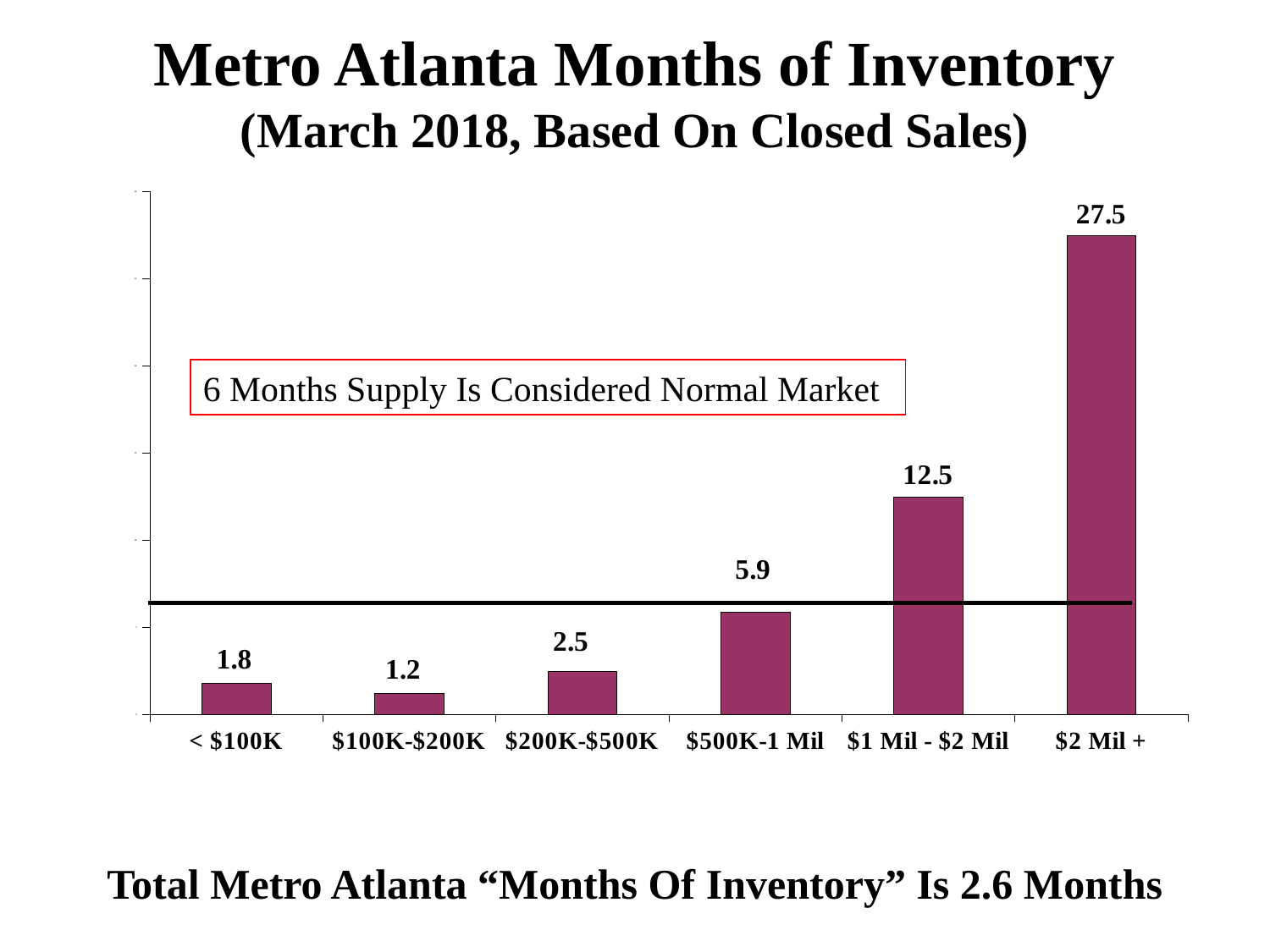
How many price range categories are shown on the chart? 6 Which price range has the lowest months of inventory? $100K-$200K What is the months of inventory value for the $1 Mil - $2 Mil price range? 12.5 Which price range has the highest months of inventory? $2 Mil + According to the text box on the chart, how many months of supply is considered a normal market? 6 months What is the difference in months of inventory between the $2 Mil + and $1 Mil - $2 Mil price ranges? 15 What is the months of inventory value for the $100K-$200K price range? 1.2 What is the months of inventory value for the $500K-1 Mil price range? 5.9 What type of chart is shown on the slide? Bar chart Do the months of inventory values generally rise or fall as the price ranges increase from left to right? Rise What is the difference in months of inventory between the $200K-$500K and < $100K price ranges? 0.7 Which has a higher months of inventory value, < $100K or $200K-$500K? $200K-$500K